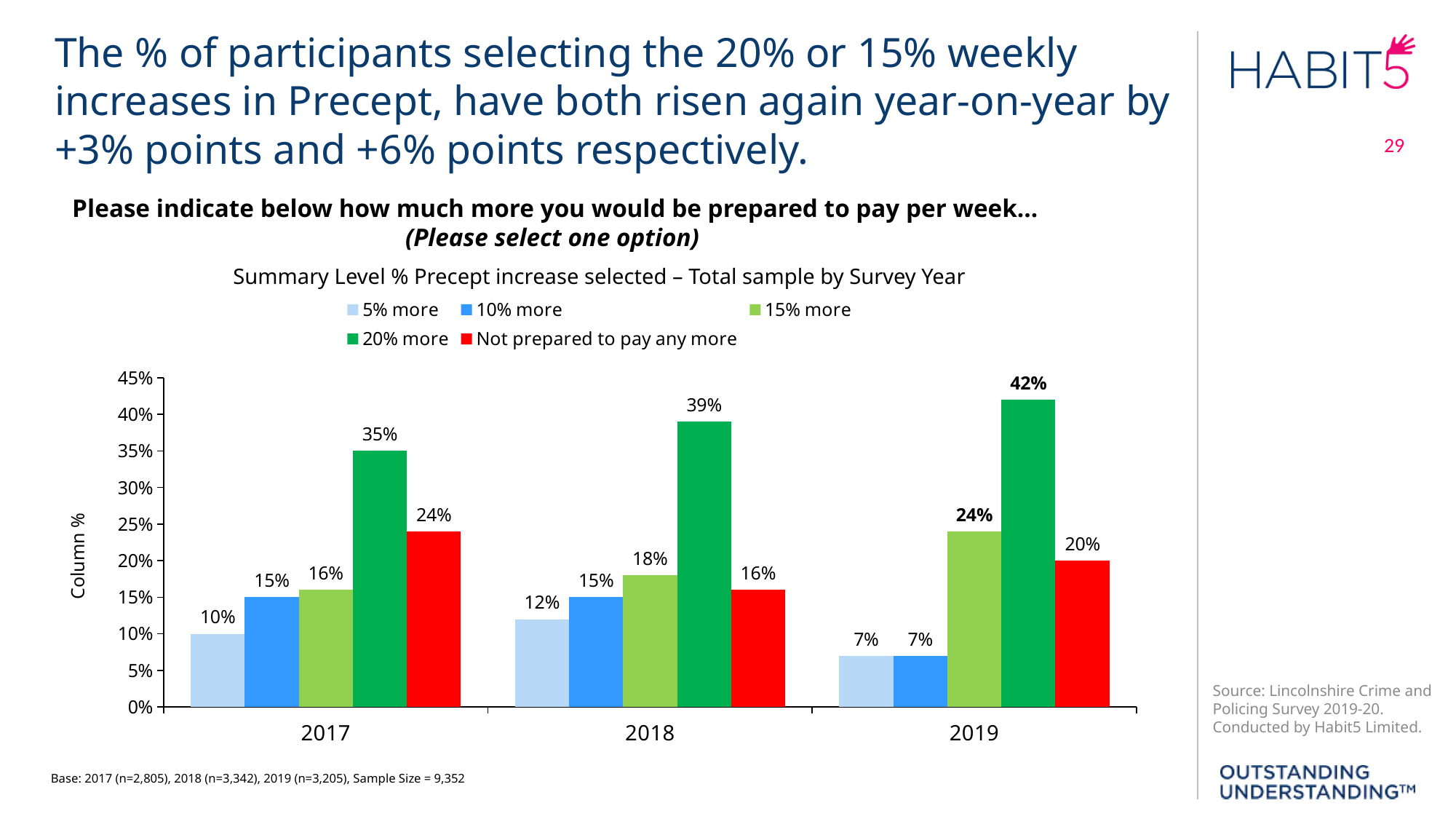
What is the difference between the '15% more' values for 2019 and 2018? 6% Which is larger: the 'Not prepared to pay any more' value in 2017 or in 2019? 2017 What percentage of participants were 'Not prepared to pay any more' in 2017? 24% How many series does the legend list? 5 What is the difference between the '20% more' values for 2019 and 2018? 3% Does the '20% more' value rise or fall from 2017 to 2019? Rise In which survey year was the '20% more' value highest? 2019 In which survey year was the '5% more' value lowest? 2019 What percentage of participants selected '5% more' in 2019? 7% What percentage of participants selected '15% more' in 2018? 18% What percentage of participants selected '20% more' in 2019? 42% What kind of chart is shown on the slide? Bar chart